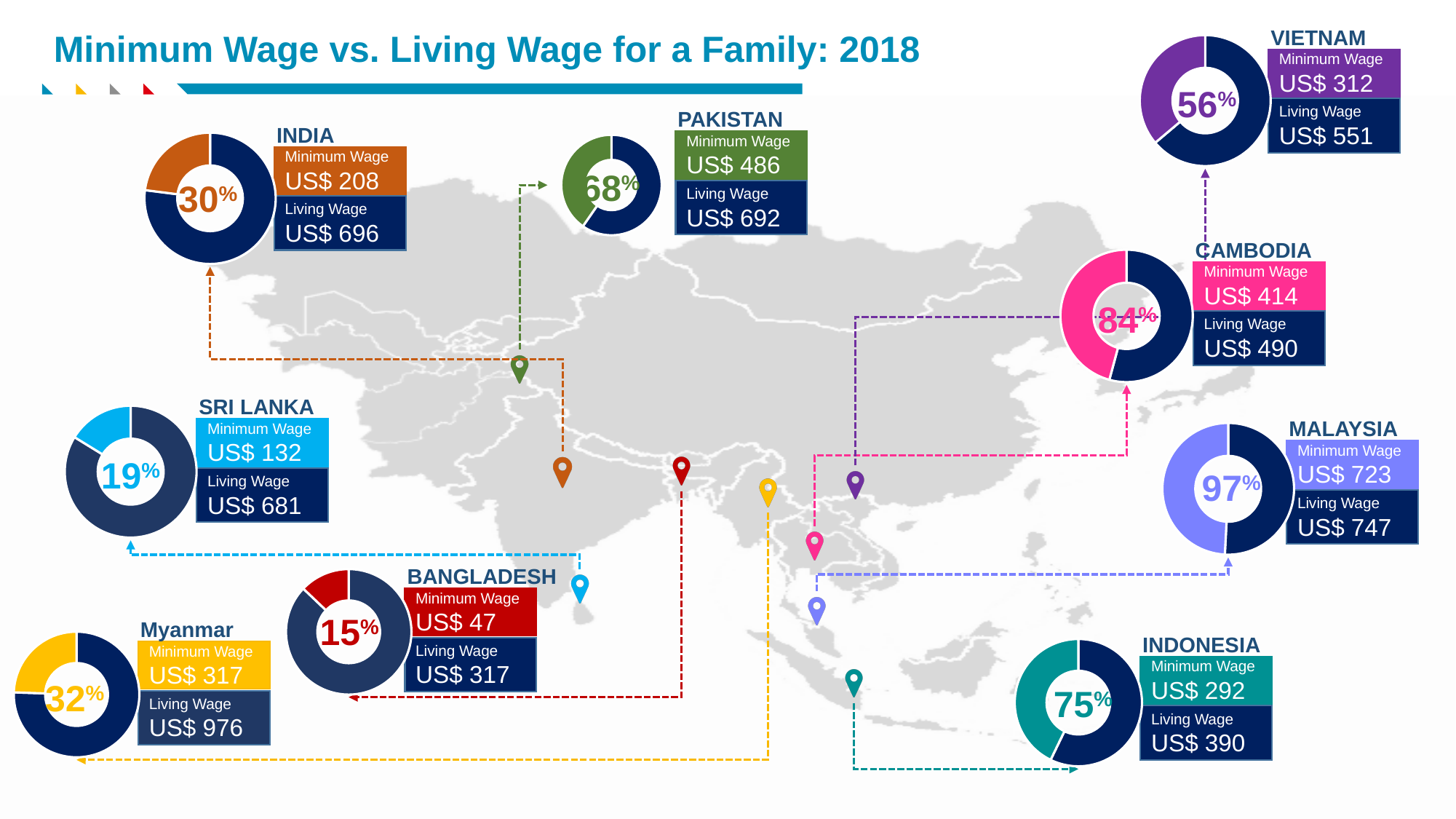
What percentage is shown in the donut chart for Malaysia? 97% What is the Minimum Wage shown for India? US$ 208 Which country has the highest percentage in its donut chart? Malaysia What is the title of the slide? Minimum Wage vs. Living Wage for a Family: 2018 What is the difference between the Living Wage and the Minimum Wage for Pakistan? US$ 206 How many countries have a donut chart on the slide? 9 Which has a higher donut chart percentage, Vietnam or Indonesia? Indonesia What is the Living Wage shown for Myanmar? US$ 976 Which country has the lowest percentage in its donut chart? Bangladesh Which has a higher Living Wage, Sri Lanka or Indonesia? Sri Lanka What is the difference between the Living Wage and the Minimum Wage for Cambodia? US$ 76 What is the Minimum Wage shown for Bangladesh? US$ 47